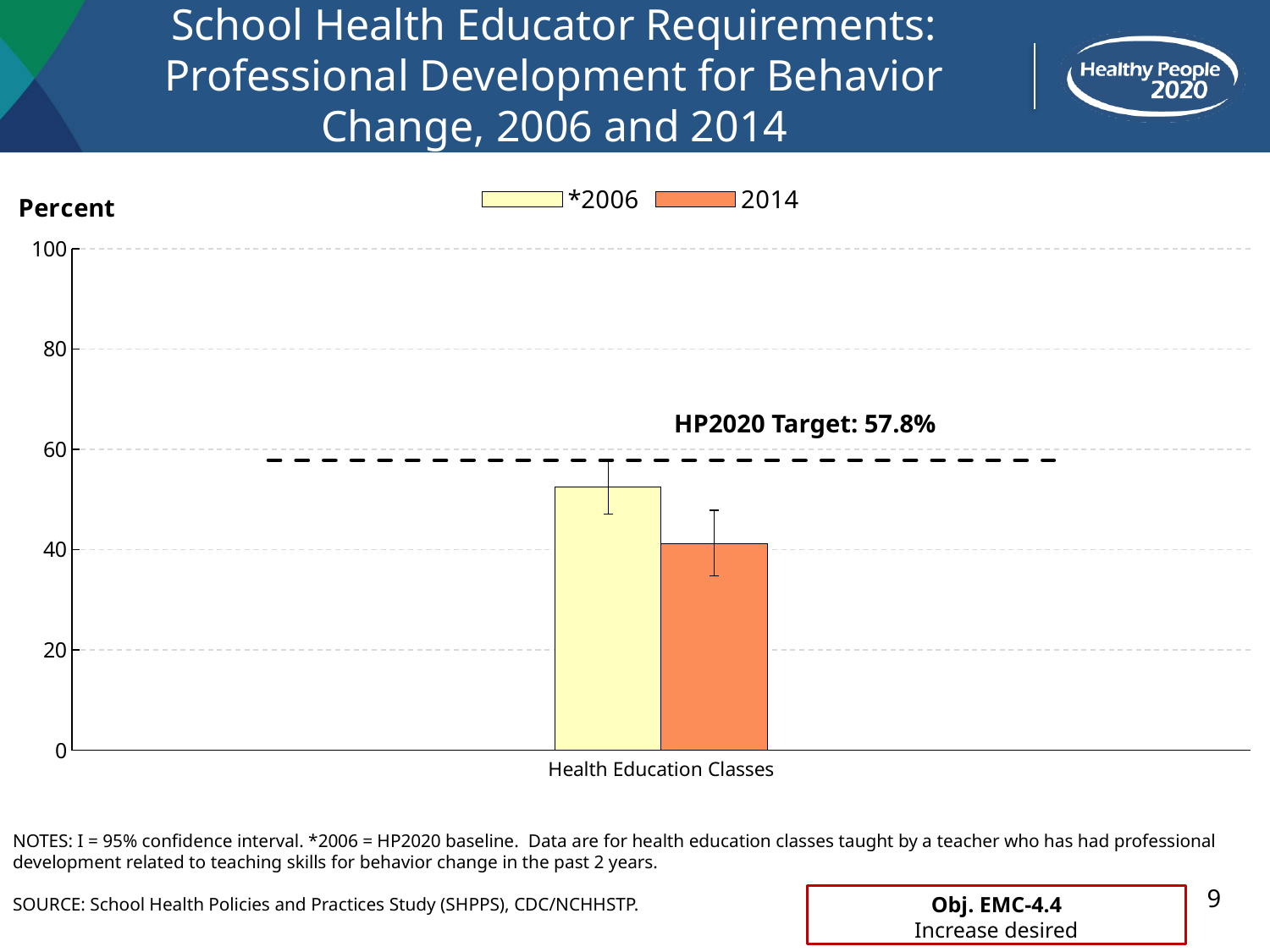
Is the 2014 value for Health Education Classes greater or less than 60? less Is the *2006 value for Health Education Classes greater or less than 60? less Did the value for Health Education Classes rise or fall from *2006 to 2014? fall What kind of chart is shown on the slide? bar chart How many categories are plotted on the x axis? 1 Is the *2006 value for Health Education Classes greater or less than 40? greater Which is larger for Health Education Classes, the *2006 value or the 2014 value? *2006 What is the label on the y axis of the chart? Percent What is the category label shown on the x axis? Health Education Classes What is the HP2020 target value shown on the chart? 57.8% How many series does the legend list? 2